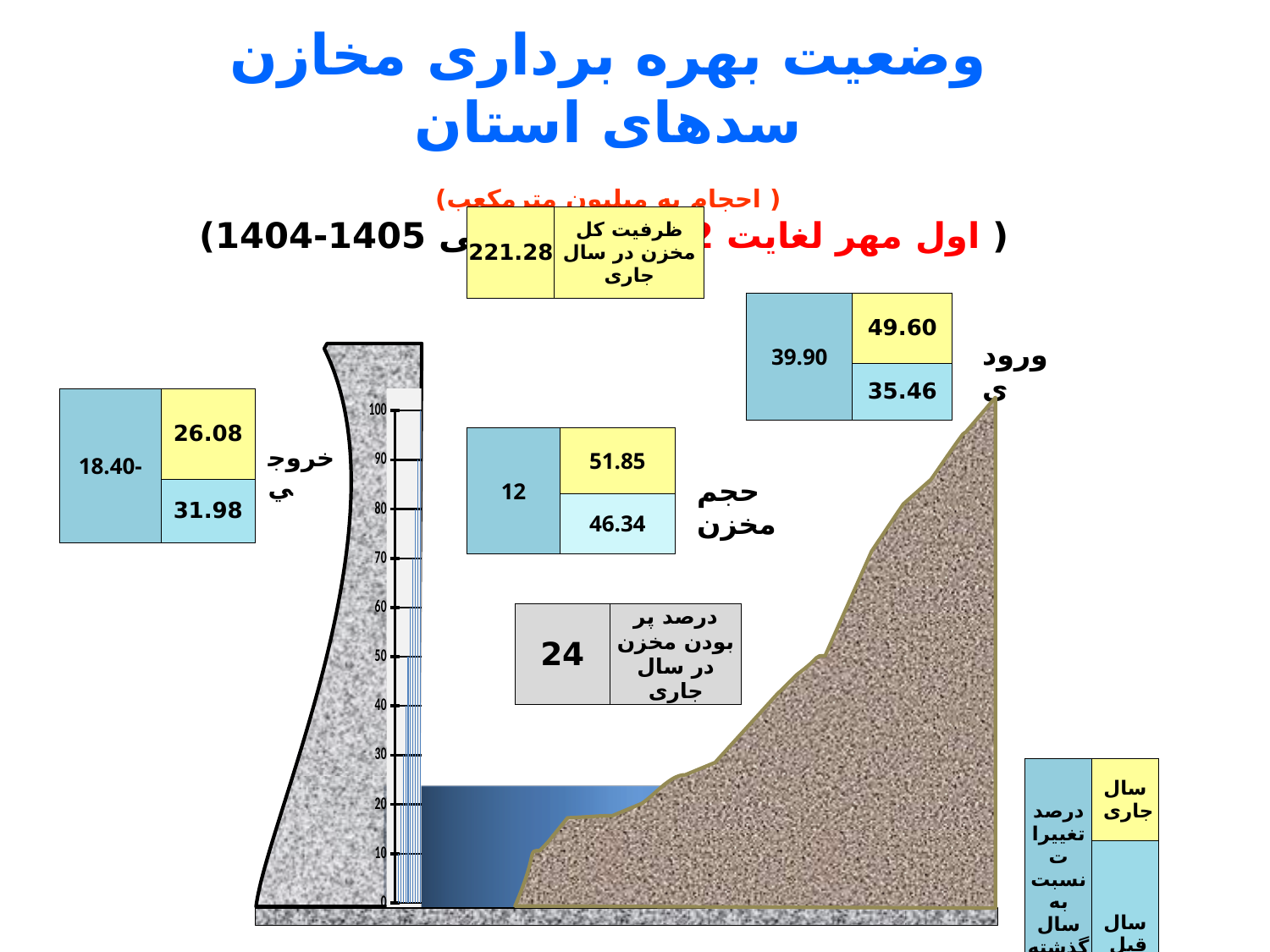
What is the inflow (ورودی) value for the current year (سال جاری, yellow cell)? 49.60 According to the legend at the bottom right, which colour represents the current year (سال جاری)? Yellow What is the outflow (خروجی) value for the previous year? 31.98 What percentage of the reservoir is full in the current year (درصد پر بودن مخزن در سال جاری)? 24 Which is larger, the current-year inflow (49.60) or the previous-year inflow (35.46)? Current year (49.60) What is the percent change in outflow (خروجی) relative to the previous year? -18.40 What is the inflow (ورودی) value for the previous year (سال قبل, light blue cell)? 35.46 What is the percent change in inflow (ورودی) relative to the previous year? 39.90 What is the reservoir volume (حجم مخزن) for the current year? 51.85 What is the difference between the current-year and previous-year reservoir volume (حجم مخزن)? 5.51 What is the total reservoir capacity in the current year (ظرفیت کل مخزن در سال جاری) shown on the slide? 221.28 What is the reservoir volume (حجم مخزن) for the previous year? 46.34